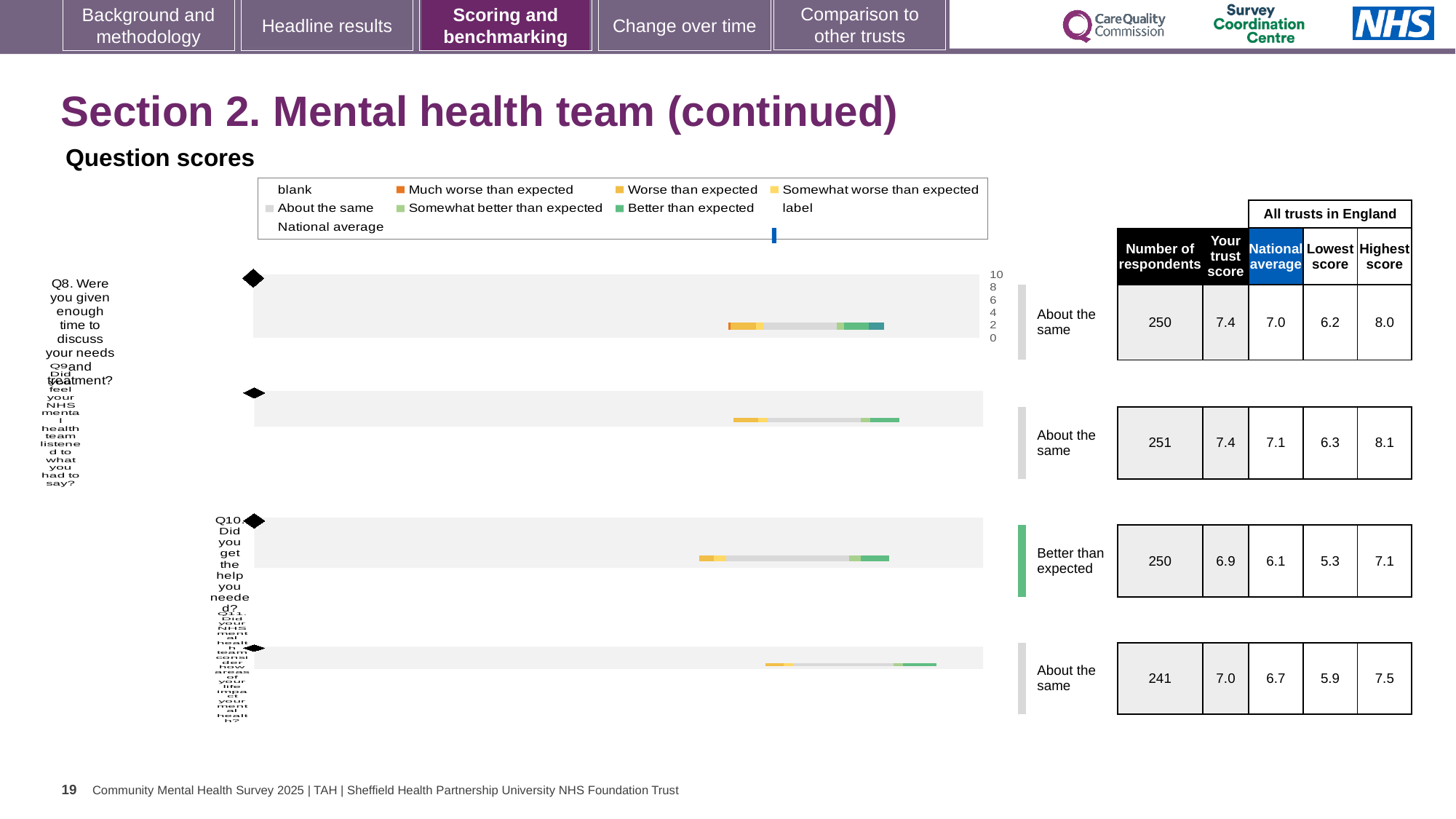
In the Q9 chart (Did you feel your NHS mental health team listened to what you had to say?), what is the National average? 7.1 Across the four question charts on the slide, which question has the highest number of respondents? Q9 In the Q10 chart, what benchmark category is the trust's result given? Better than expected In the Q11 chart, what is the Lowest score across all trusts in England? 5.9 In the Q8 chart, what is the difference between 'Your trust score' and the National average? 0.4 What kind of chart is used for each question score on the slide? Bar chart Across the four question charts on the slide, which question has the lowest 'Your trust score'? Q10 In the Q8 chart, how many respondents are shown? 250 In the Q11 chart, which is larger: 'Your trust score' or the National average? Your trust score In the Q8 chart (Were you given enough time to discuss your needs and treatment?), what is the 'Your trust score' value? 7.4 How many question charts are shown on the slide? 4 In the Q10 chart (Did you get the help you needed?), what is the Highest score across all trusts in England? 7.1